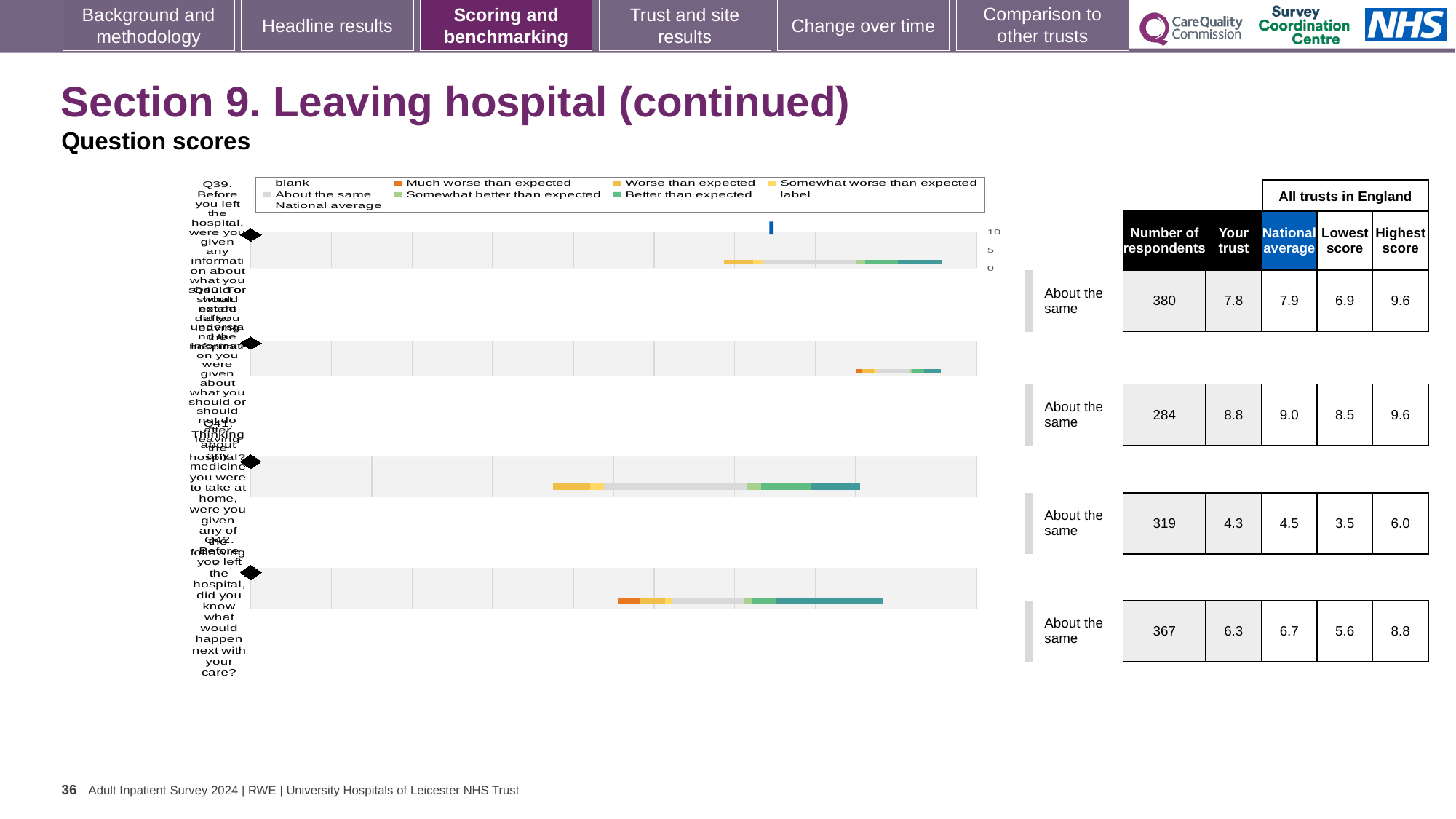
How many questions (bars) are plotted in the chart? 4 For Q42 (the last row), what is the difference between the national average and the 'Your trust' score? 0.4 What colour does the legend use for 'Much worse than expected'? orange In the table, what is the highest score in England for Q42 (the last row)? 8.8 In the table, what is the 'Your trust' score for Q39 (the first row)? 7.8 What benchmark label is shown next to each of the four bars? About the same In the table, what is the lowest score in England for the third row? 3.5 Which row of the table has the lowest 'Your trust' score? the third row (4.3) For Q39 (the first row), which is larger: the 'Your trust' score or the national average? the national average (7.9) In the table, what is the number of respondents for Q39 (the first row)? 380 Which row of the table has the highest 'Your trust' score? the second row (8.8) What kind of chart is shown on the slide? bar chart